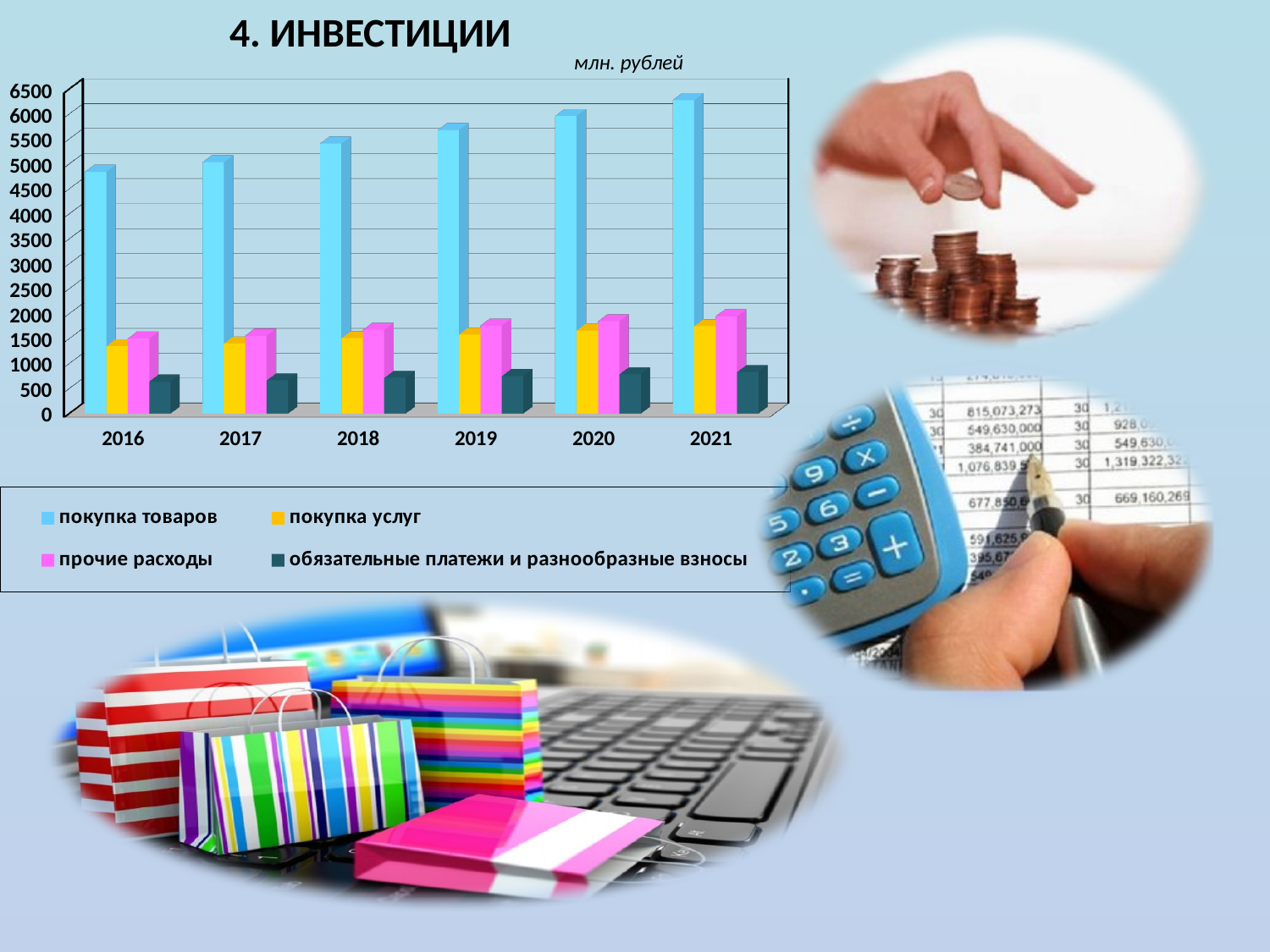
What unit is stated above the chart? млн. рублей Which series has the lowest value in 2016? обязательные платежи и разнообразные взносы Is the value for обязательные платежи и разнообразные взносы in 2016 greater or less than 1000? less How many years are shown on the x axis of the chart? 6 Which series has the highest value in 2021? покупка товаров Is the value for покупка товаров in 2016 greater or less than 5500? less In 2021, which is larger: прочие расходы or покупка услуг? прочие расходы Is the value for покупка товаров in 2021 greater or less than 5500? greater Does the value for покупка товаров rise or fall from 2016 to 2021? rise How many series does the chart legend list? 4 What kind of chart is shown on the slide? bar chart